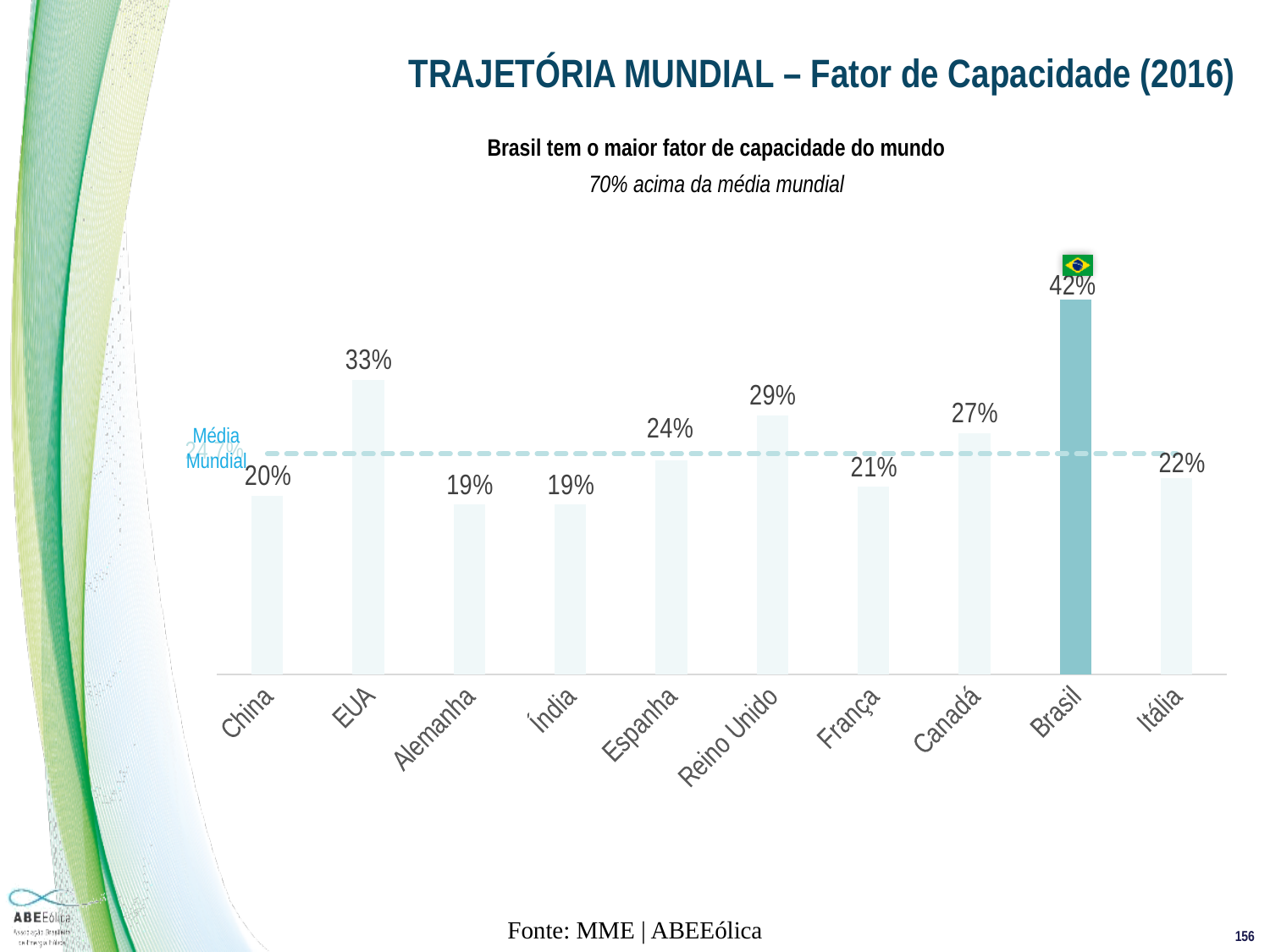
What type of chart is shown on the slide? Bar chart Which has a higher value, Canadá or Reino Unido? Reino Unido What is the difference between the values for Espanha and China? 4% Which countries share the lowest value on the chart? Alemanha and Índia What is the capacity factor shown for EUA? 33% Which country has the highest capacity factor on the chart? Brasil What value is shown for Canadá? 27% What is the capacity factor shown for Brasil? 42% How many countries are shown on the chart? 10 What does the dashed horizontal line on the chart represent? Média Mundial What is the difference between the values for Brasil and EUA? 9% What value is shown for Reino Unido? 29%